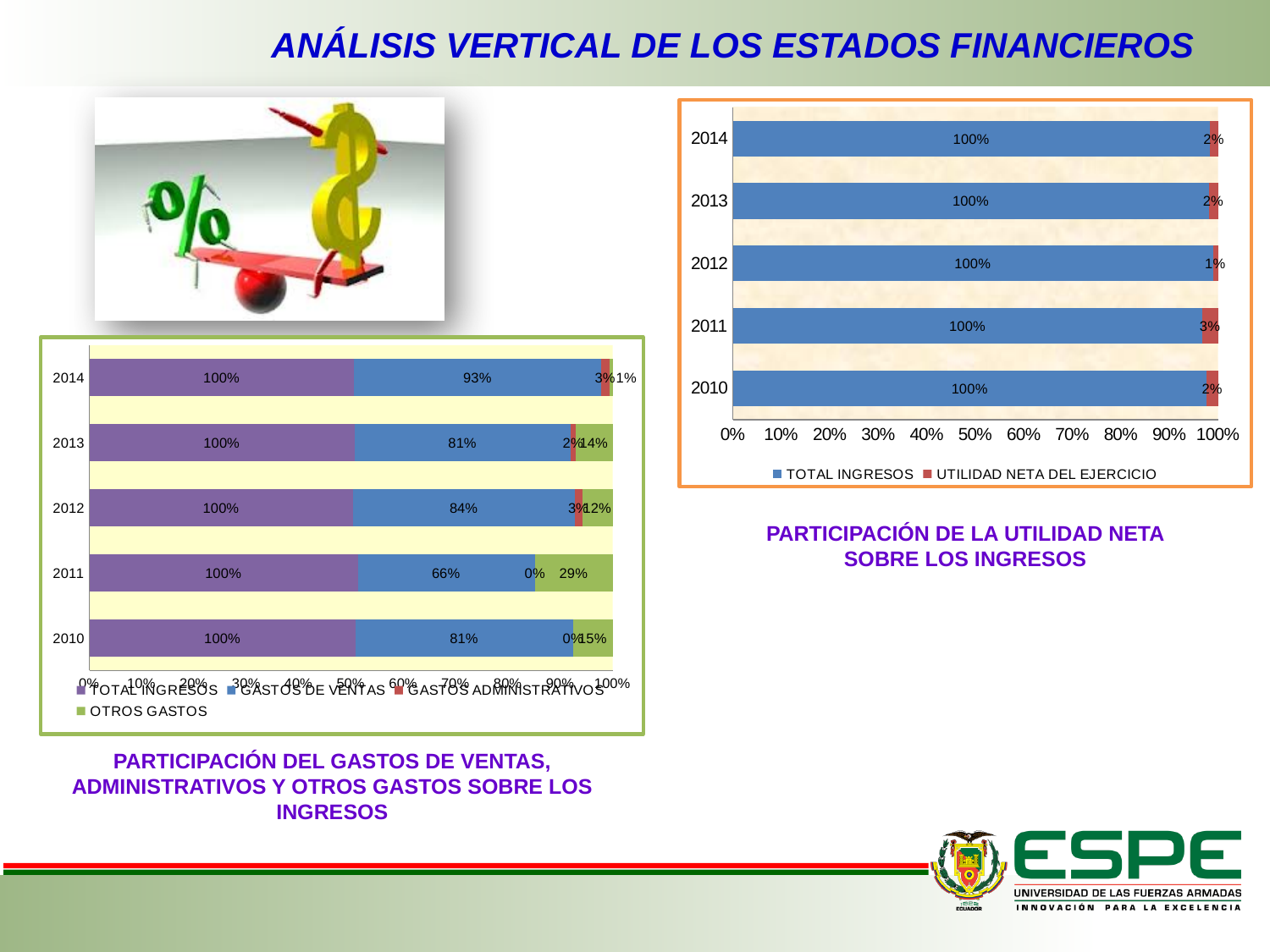
In the chart titled 'PARTICIPACIÓN DEL GASTOS DE VENTAS, ADMINISTRATIVOS Y OTROS GASTOS SOBRE LOS INGRESOS', what is the difference between GASTOS DE VENTAS in 2014 and in 2011? 27% In the chart titled 'PARTICIPACIÓN DEL GASTOS DE VENTAS, ADMINISTRATIVOS Y OTROS GASTOS SOBRE LOS INGRESOS', is GASTOS DE VENTAS larger in 2012 or in 2013? 2012 In the chart titled 'PARTICIPACIÓN DE LA UTILIDAD NETA SOBRE LOS INGRESOS', which year has the lowest UTILIDAD NETA DEL EJERCICIO? 2012 In the chart titled 'PARTICIPACIÓN DE LA UTILIDAD NETA SOBRE LOS INGRESOS', what is the value of UTILIDAD NETA DEL EJERCICIO for 2011? 3% In the chart titled 'PARTICIPACIÓN DEL GASTOS DE VENTAS, ADMINISTRATIVOS Y OTROS GASTOS SOBRE LOS INGRESOS', what is the value of OTROS GASTOS for 2011? 29% In the chart titled 'PARTICIPACIÓN DE LA UTILIDAD NETA SOBRE LOS INGRESOS', which year has the highest UTILIDAD NETA DEL EJERCICIO? 2011 What kind of chart is the one titled 'PARTICIPACIÓN DEL GASTOS DE VENTAS, ADMINISTRATIVOS Y OTROS GASTOS SOBRE LOS INGRESOS'? Stacked bar chart In the chart titled 'PARTICIPACIÓN DEL GASTOS DE VENTAS, ADMINISTRATIVOS Y OTROS GASTOS SOBRE LOS INGRESOS', which year has the lowest GASTOS DE VENTAS? 2011 In the chart titled 'PARTICIPACIÓN DE LA UTILIDAD NETA SOBRE LOS INGRESOS', how many years are shown? 5 In the chart titled 'PARTICIPACIÓN DE LA UTILIDAD NETA SOBRE LOS INGRESOS', what is the value of UTILIDAD NETA DEL EJERCICIO for 2012? 1% In the chart titled 'PARTICIPACIÓN DE LA UTILIDAD NETA SOBRE LOS INGRESOS', how many series does the legend list? 2 In the chart titled 'PARTICIPACIÓN DEL GASTOS DE VENTAS, ADMINISTRATIVOS Y OTROS GASTOS SOBRE LOS INGRESOS', what is the value of GASTOS DE VENTAS for 2014? 93%